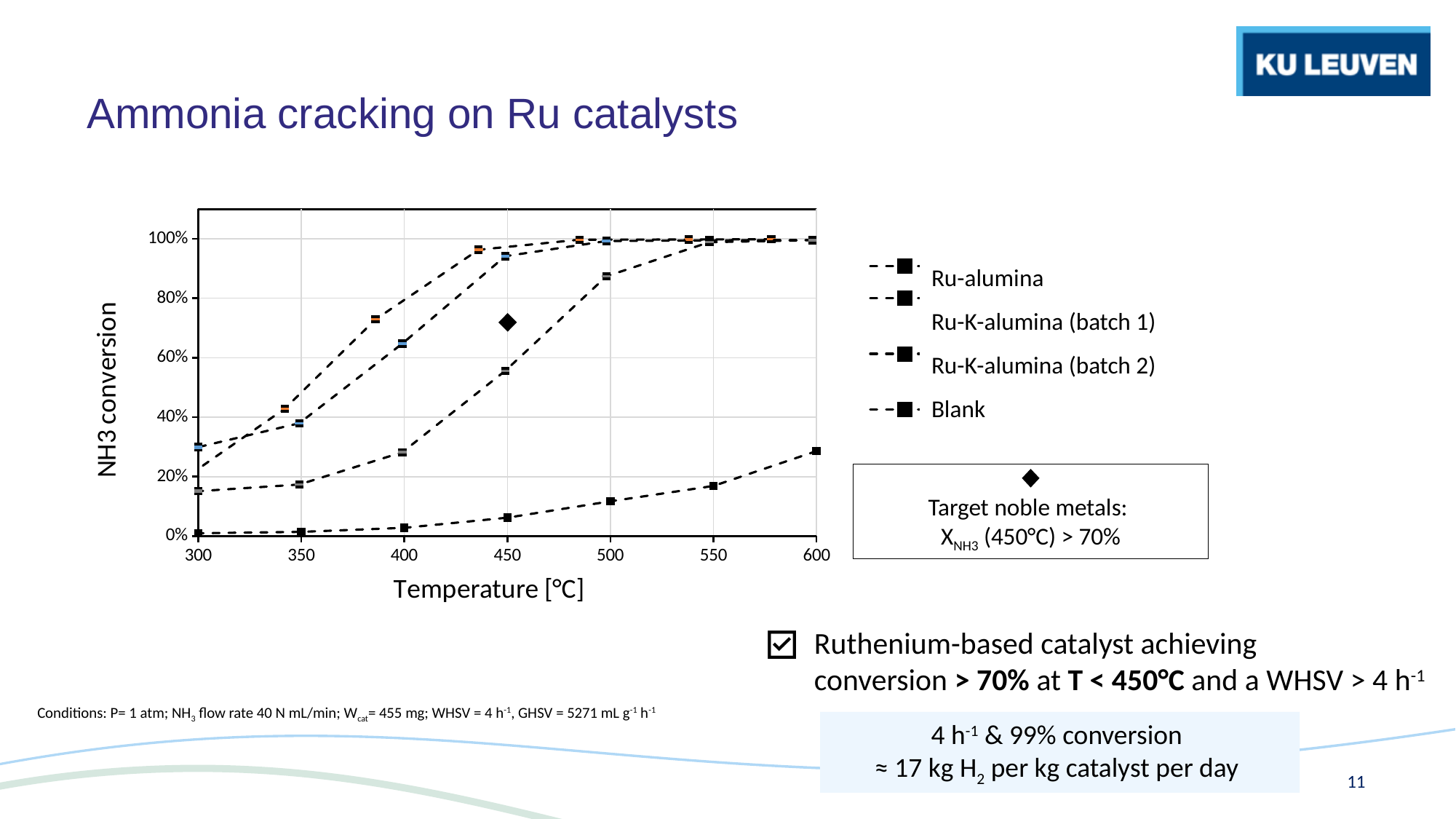
What is the label of the y axis of the chart? NH3 conversion What is the highest temperature shown on the x axis of the chart? 600 What kind of chart is shown on the slide? line chart What is the label of the x axis of the chart? Temperature [°C] What is the lowest temperature shown on the x axis of the chart? 300 Is the value of the lowest curve at 300°C greater or less than 20%? less Is the value of the highest curve at 450°C greater or less than 80%? greater At which temperature is the 'Target noble metals' diamond marker placed on the chart? 450°C How many curves on the chart reach close to 100% conversion by 600°C? 3 Do the NH3 conversion curves rise or fall as temperature increases along the x axis? rise Is the value of the lowest curve at 600°C greater or less than 40%? less How many series does the legend of the chart list? 4